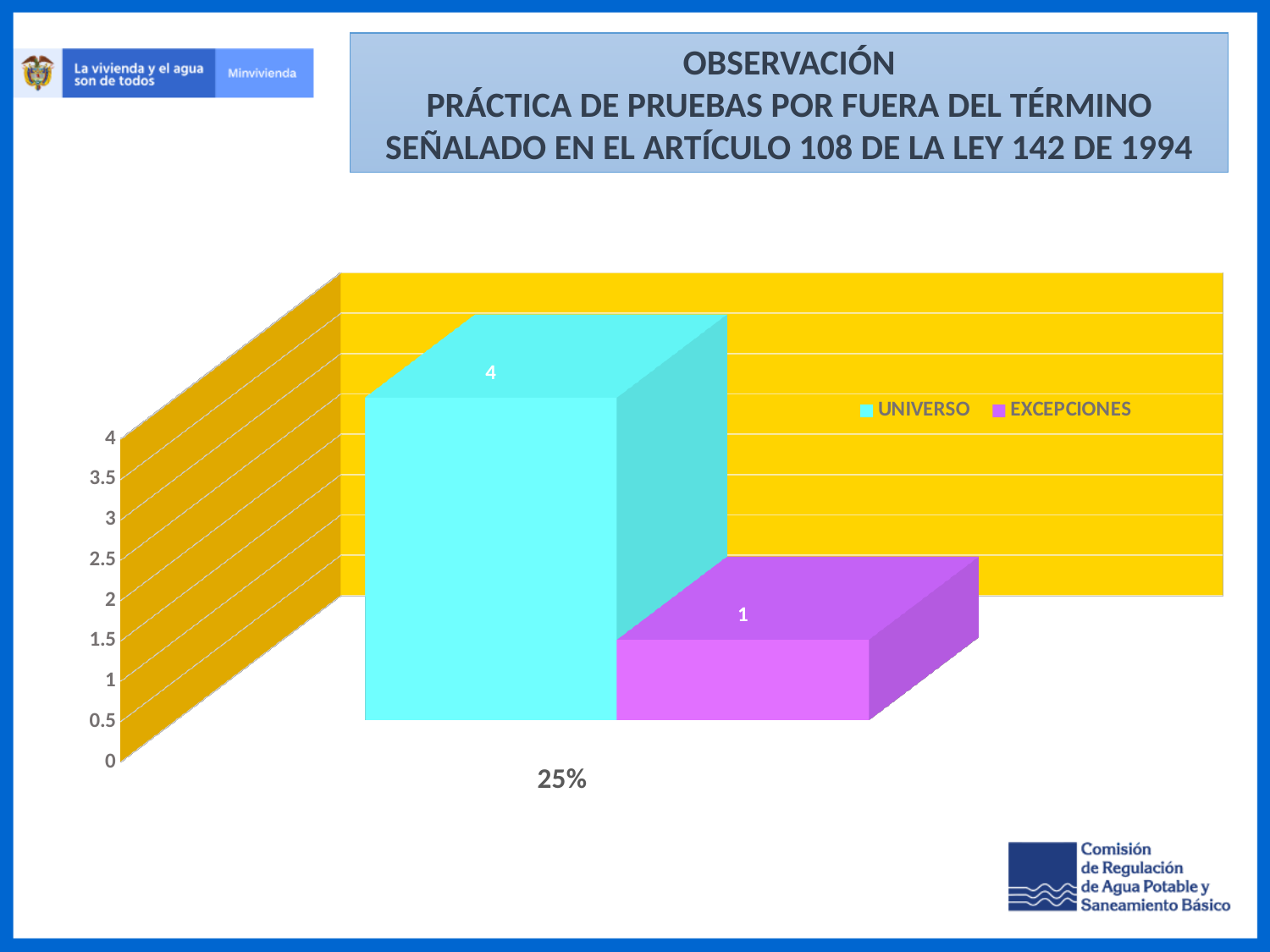
Which series has the higher value, UNIVERSO or EXCEPCIONES? UNIVERSO How many series does the legend list? 2 What is the highest value shown on the vertical axis? 4 Is the value for UNIVERSO greater or less than 2? greater Which series has the lowest value? EXCEPCIONES What is the value for EXCEPCIONES? 1 What kind of chart is shown on the slide? bar chart What is the difference between the UNIVERSO and EXCEPCIONES values? 3 What is the category label shown below the bars? 25% What is the value for UNIVERSO? 4 Is the value for EXCEPCIONES greater or less than 2? less